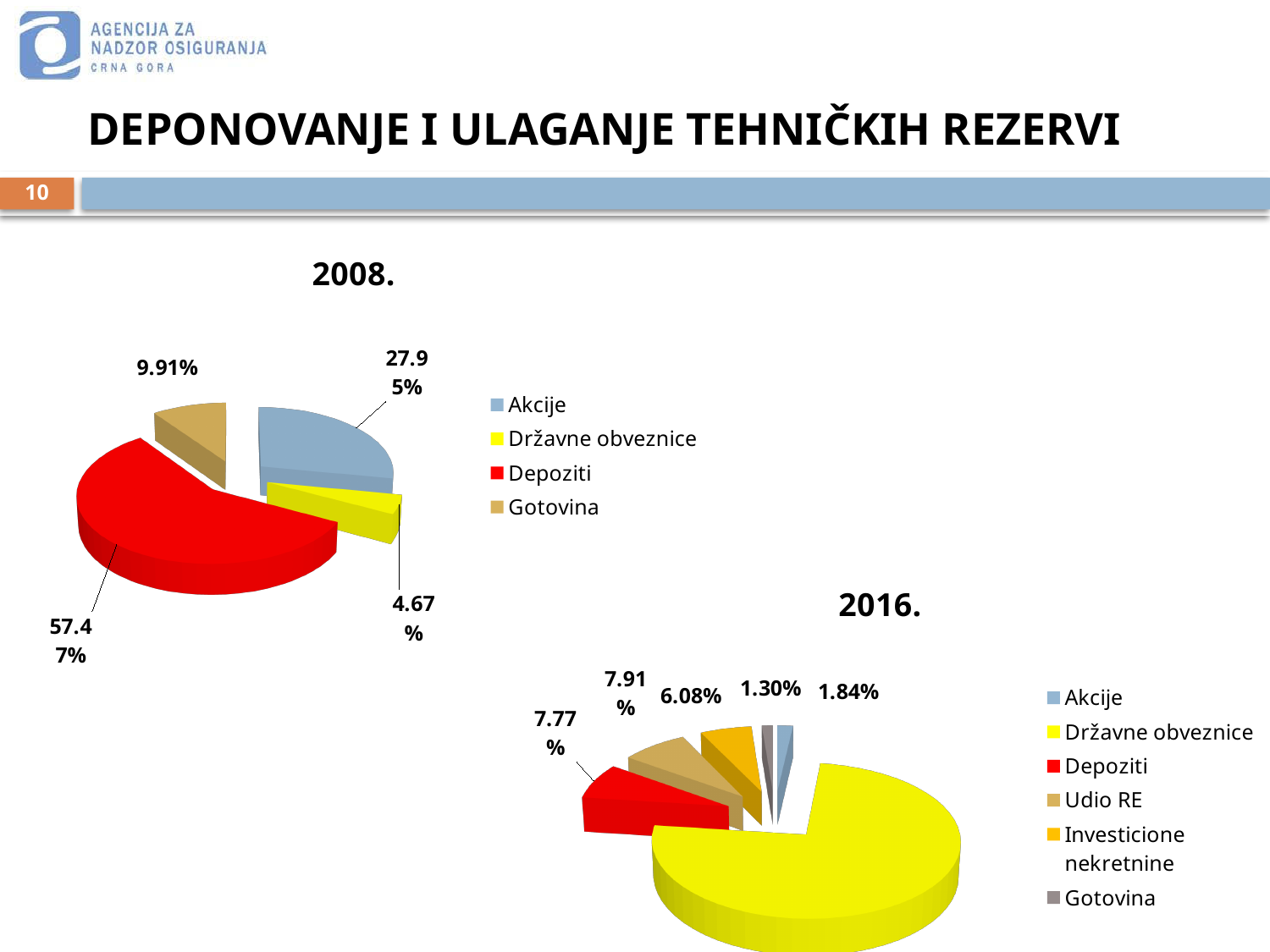
In the 2008 pie chart, which category has the largest share? Depoziti In the 2016 pie chart, which is larger, the share of Depoziti or the share of Investicione nekretnine? Depoziti How many categories does the legend of the 2016 pie chart list? 6 In the 2008 pie chart, which category has the smallest share? Državne obveznice In the 2008 pie chart, what share is labelled for Državne obveznice? 4.67% How many categories does the legend of the 2008 pie chart list? 4 In the 2008 pie chart, what is the difference between the shares of Depoziti and Akcije? 29.52% In the 2008 pie chart, what share is labelled for Depoziti? 57.47% In the 2016 pie chart, which category has the largest share? Državne obveznice In the 2008 pie chart, what share is labelled for Akcije? 27.95% In the 2016 pie chart, what share is labelled for Gotovina? 1.30% In the 2016 pie chart, what share is labelled for Udio RE? 7.91%